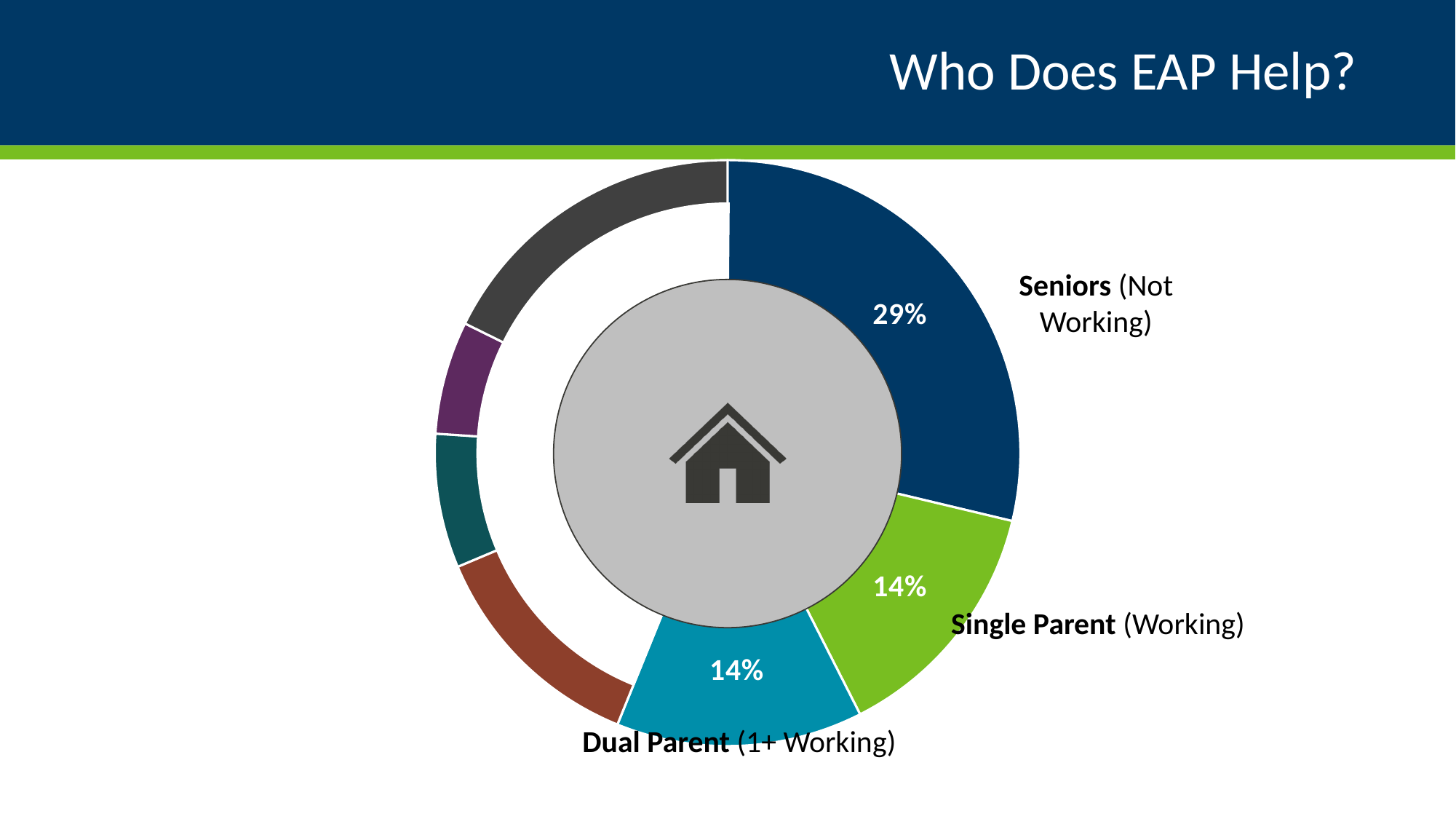
What is the title of the slide? Who Does EAP Help? What percentage of the pie chart is labelled for Seniors (Not Working)? 29% What percentage is shown for Single Parent (Working)? 14% What percentage is shown for Dual Parent (1+ Working)? 14% Which is larger, the share for Seniors (Not Working) or the share for Single Parent (Working)? Seniors (Not Working) How many slices of the pie chart have a percentage label printed on them? 3 What colour is the slice for Seniors (Not Working)? Dark blue How many slices does the pie chart have in total? 7 What kind of chart is shown on the slide? Pie chart (donut) How many percentage points larger is the Seniors (Not Working) share than the Dual Parent (1+ Working) share? 15 percentage points What is the combined share of the three labelled groups (Seniors, Single Parent, Dual Parent)? 57% Which labelled group has the largest share of the pie chart? Seniors (Not Working)